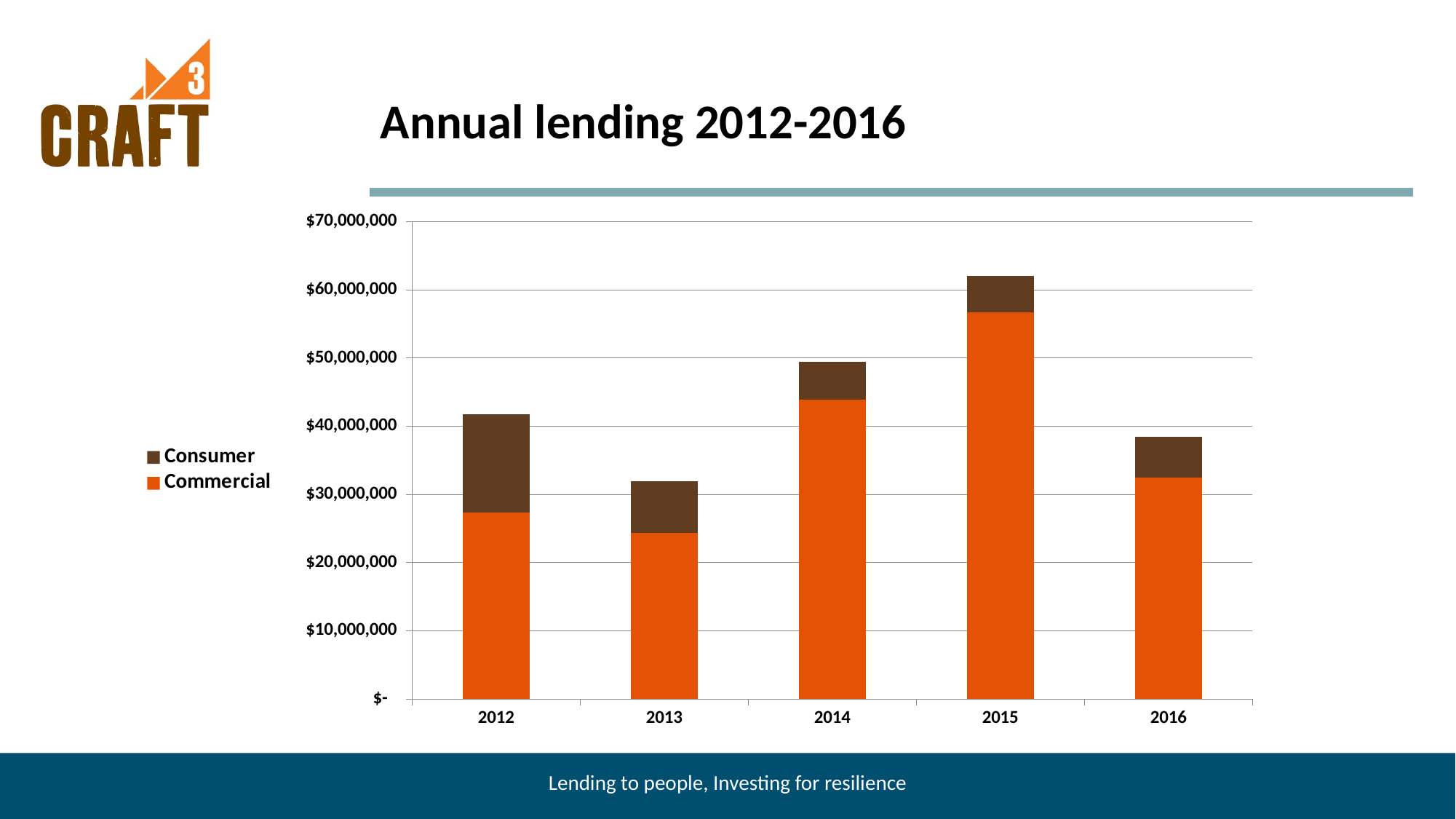
How many series does the chart's legend list? 2 Is the Commercial lending for 2015 greater or less than $50,000,000? greater Is the Commercial lending for 2013 greater or less than $30,000,000? less Is the total lending for 2015 greater or less than $60,000,000? greater How many years are shown on the x axis of the chart? 5 Which year has larger total lending, 2012 or 2016? 2012 Which series is shown in orange in the chart? Commercial Which year has the lowest total lending? 2013 What is the title of the chart on the slide? Annual lending 2012-2016 What kind of chart is shown on the slide? Stacked bar chart Which year has the highest total lending? 2015